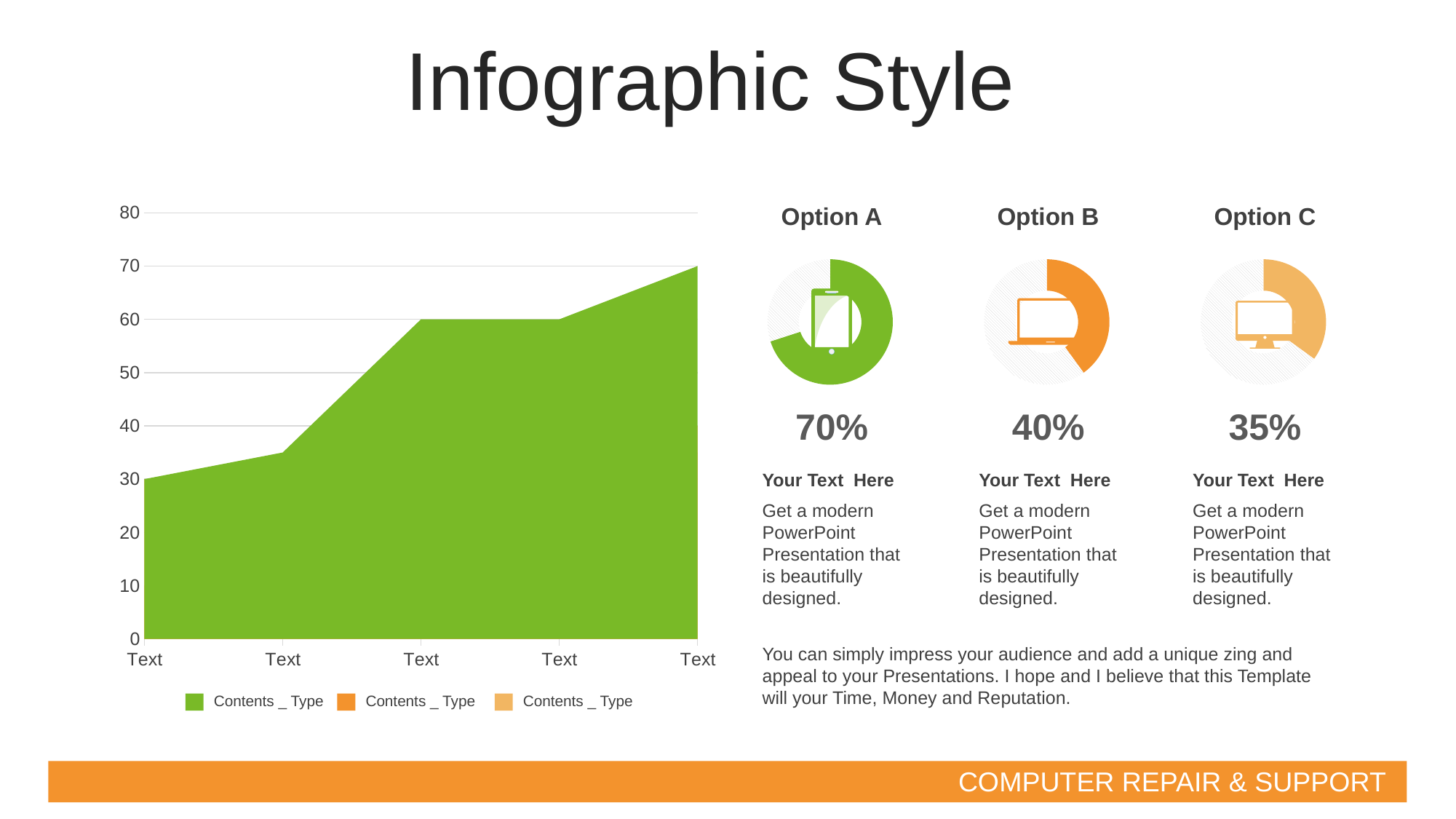
What kind of chart is shown on the left of the slide? area chart Which point in the area chart has the highest value? the last (rightmost) point Which point in the area chart has the lowest value? the first (leftmost) point What is the difference between the last point and the first point in the area chart? 40 Is the value of the second point in the area chart greater or less than 40? less What is the value of the first (leftmost) point in the area chart? 30 How many series does the legend of the area chart list? 3 What is the value of the last (rightmost) point in the area chart? 70 What is the value of the third point in the area chart? 60 Do the values in the area chart generally rise or fall from left to right? rise How many data points are plotted along the x axis of the area chart? 5 What colour is the plotted area in the chart? green